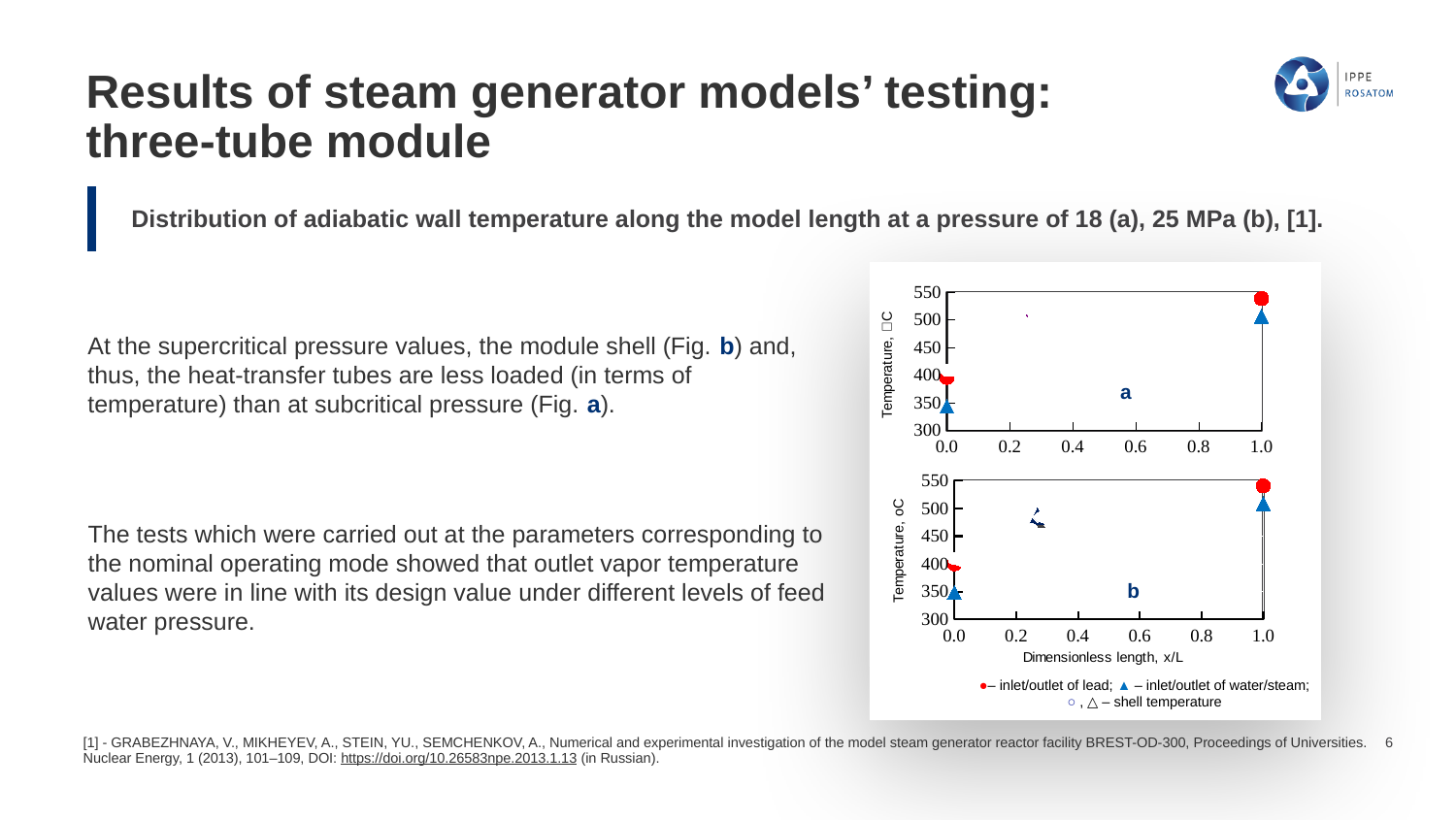
In chart (a), is the lead temperature at dimensionless length 1.0 greater or less than 500? greater What kind of chart is chart (a) on the slide? scatter chart In chart (a), at dimensionless length 1.0, which is higher: the lead temperature or the water/steam temperature? lead temperature In chart (b), is the water/steam temperature at dimensionless length 0.0 greater or less than 400? less In chart (a), is the water/steam temperature at dimensionless length 0.0 greater or less than 400? less What is the label of the x axis of chart (b)? Dimensionless length, x/L How many charts are shown on the slide? 2 In chart (a), does the lead temperature rise or fall from dimensionless length 0.0 to 1.0? rise According to the legend, what do the red circle markers represent? inlet/outlet of lead What is the highest tick value shown on the y axis of chart (a)? 550 In chart (b), at dimensionless length 0.0, which is higher: the lead temperature or the water/steam temperature? lead temperature